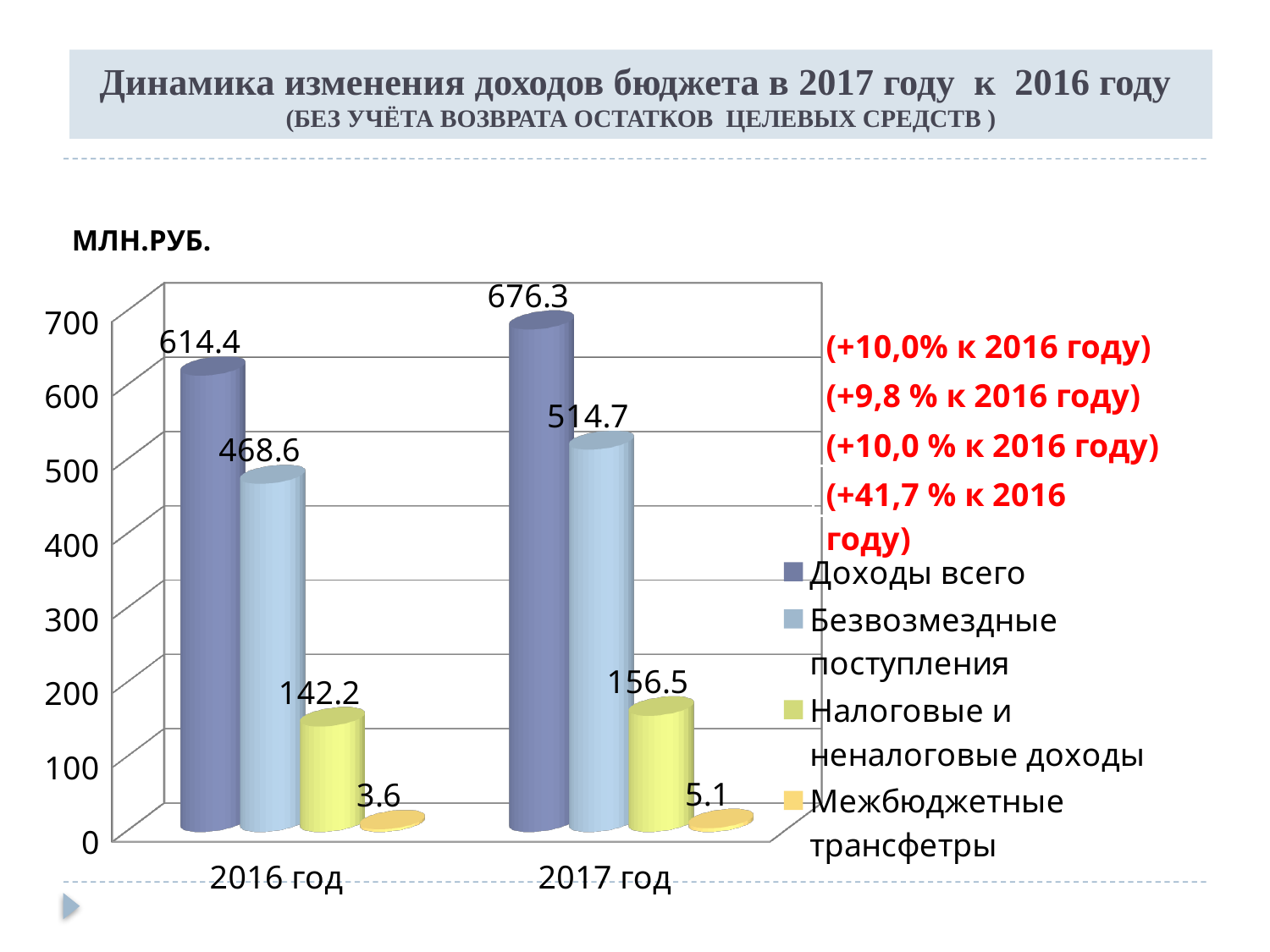
How many year categories are shown on the x axis? 2 How many series does the legend list? 4 Which series has the highest value in 2016 год? Доходы всего What is the value of Доходы всего for 2017 год? 676.3 Which series has the lowest value in 2017 год? Межбюджетные трансферты What kind of chart is shown on the slide? Bar chart Which is larger: Безвозмездные поступления in 2016 год or in 2017 год? 2017 год What is the value of Межбюджетные трансферты for 2016 год? 3.6 What is the value of Налоговые и неналоговые доходы for 2017 год? 156.5 What is the value of Безвозмездные поступления for 2016 год? 468.6 What is the difference between Доходы всего in 2017 год and in 2016 год? 61.9 Does the value of Налоговые и неналоговые доходы rise or fall from 2016 год to 2017 год? Rise